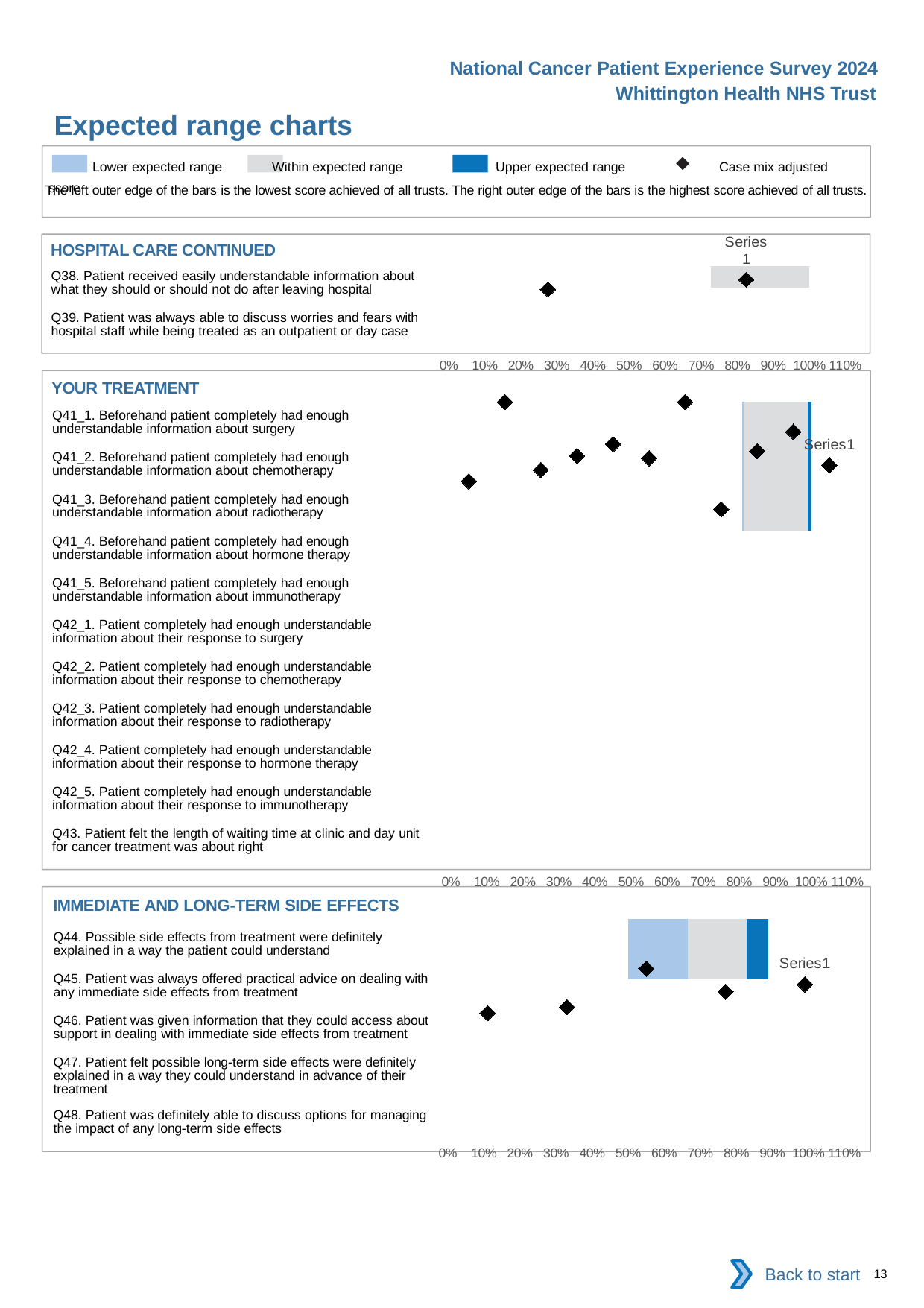
How many questions are listed in the HOSPITAL CARE CONTINUED chart? 2 In the IMMEDIATE AND LONG-TERM SIDE EFFECTS chart, is the leftmost diamond marker greater or less than 20%? less How many questions are listed in the IMMEDIATE AND LONG-TERM SIDE EFFECTS chart? 5 In the YOUR TREATMENT chart, is the rightmost diamond marker greater or less than 90%? greater In the HOSPITAL CARE CONTINUED chart, is the diamond marker inside the grey bar greater or less than 70%? greater What is the highest tick label shown on the horizontal axis of the YOUR TREATMENT chart? 110% How many entries does the legend at the top of the slide list? 4 How many charts (sections) are shown on the slide? 3 What marker shape is used to show the case mix adjusted score? Diamond